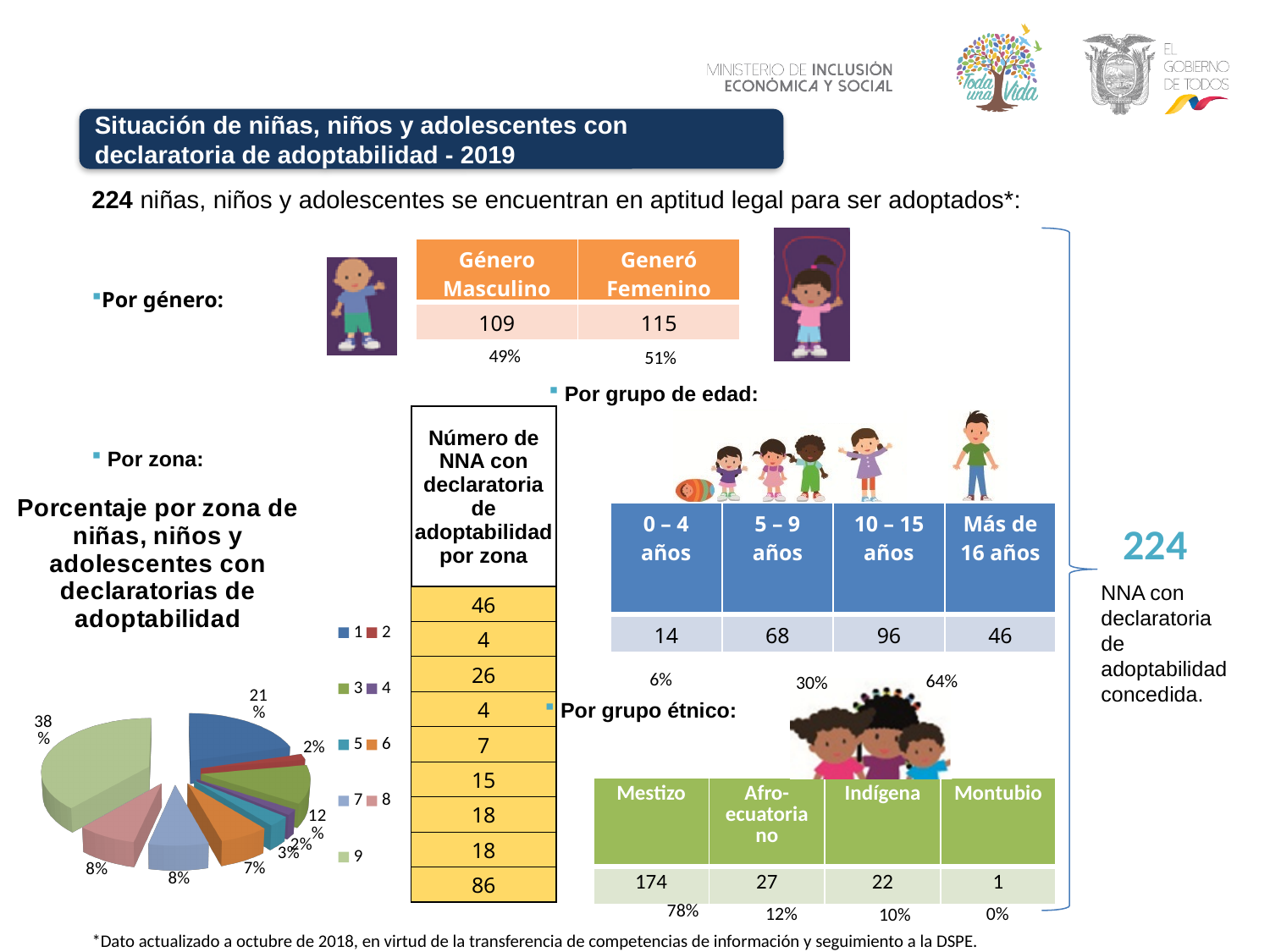
What percentage is shown for the slice labelled 1 (the blue slice) in the pie chart? 21% How many entries does the legend of the pie chart list? 9 Which slice is larger in the pie chart, the one for 1 or the one for 9? 9 What is the title of the pie chart? Porcentaje por zona de niñas, niños y adolescentes con declaratorias de adoptabilidad What colour is the largest slice of the pie chart? light green Which legend entry corresponds to the largest slice of the pie chart? 9 How many slices does the pie chart have? 9 What is the largest percentage shown on the pie chart? 38% What is the smallest percentage shown as a data label on the pie chart? 2% What percentage is shown for the slice labelled 3 (the green slice) in the pie chart? 12% What kind of chart is shown on the slide? pie chart What is the difference in percentage points between the 38% slice and the 21% slice in the pie chart? 17